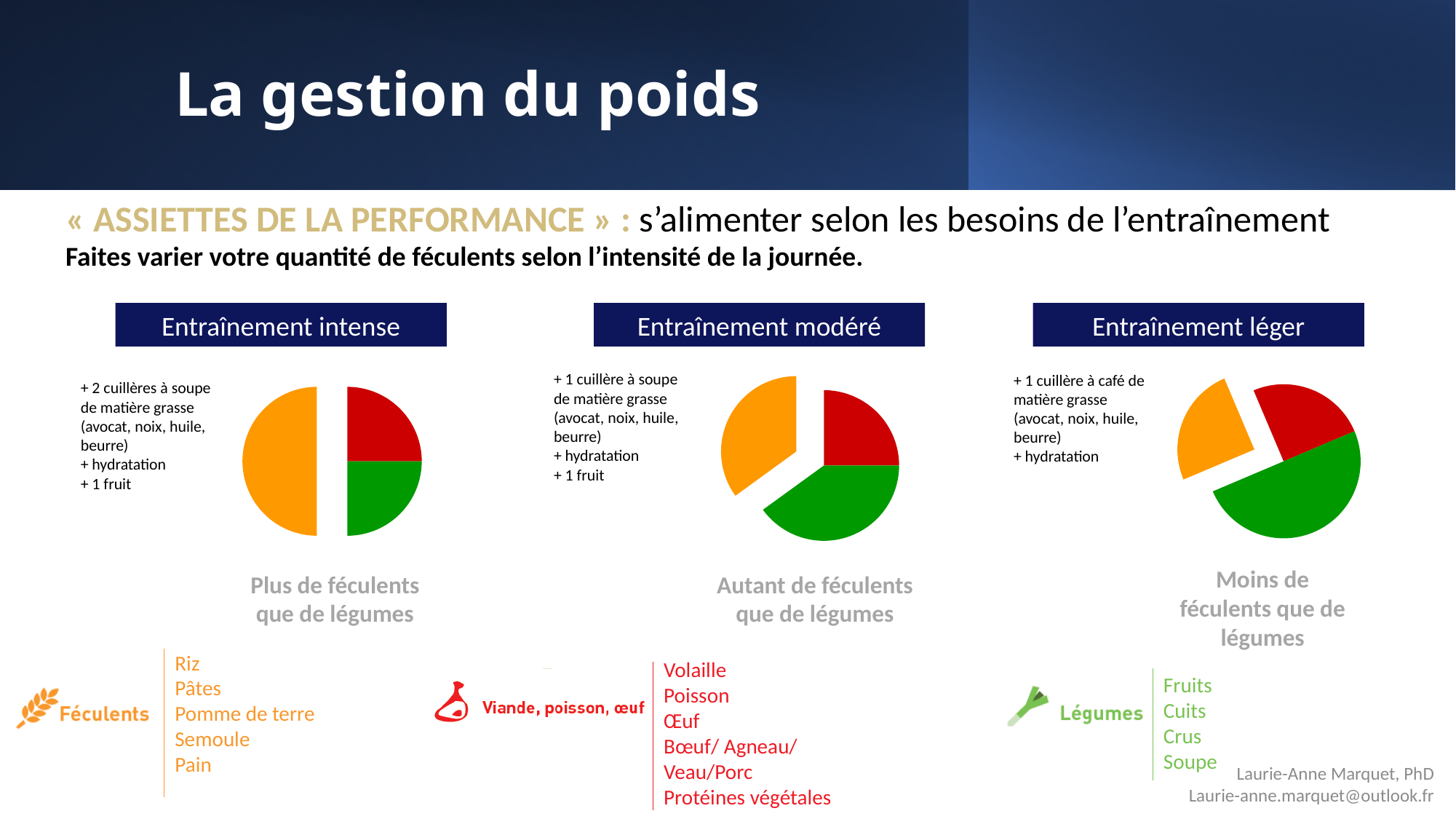
In the "Entraînement modéré" pie chart, which food group has the smallest slice? Viande, poisson, œuf Which colour represents Légumes in the pie charts? green In the "Entraînement modéré" pie chart, which slice is larger: Légumes or Viande, poisson, œuf? Légumes In the "Entraînement intense" pie chart, which slice is larger: Féculents or Viande, poisson, œuf? Féculents How many slices does the "Entraînement intense" pie chart have? 3 In the "Entraînement léger" pie chart, which slice is larger: Légumes or Viande, poisson, œuf? Légumes What kind of chart is used under "Entraînement intense"? pie chart What caption is written under the "Entraînement modéré" pie chart? Autant de féculents que de légumes In the "Entraînement intense" pie chart, which food group has the largest slice? Féculents How many pie charts are shown on the slide? 3 In the "Entraînement léger" pie chart, which food group has the largest slice? Légumes How many slices does the "Entraînement léger" pie chart have? 3